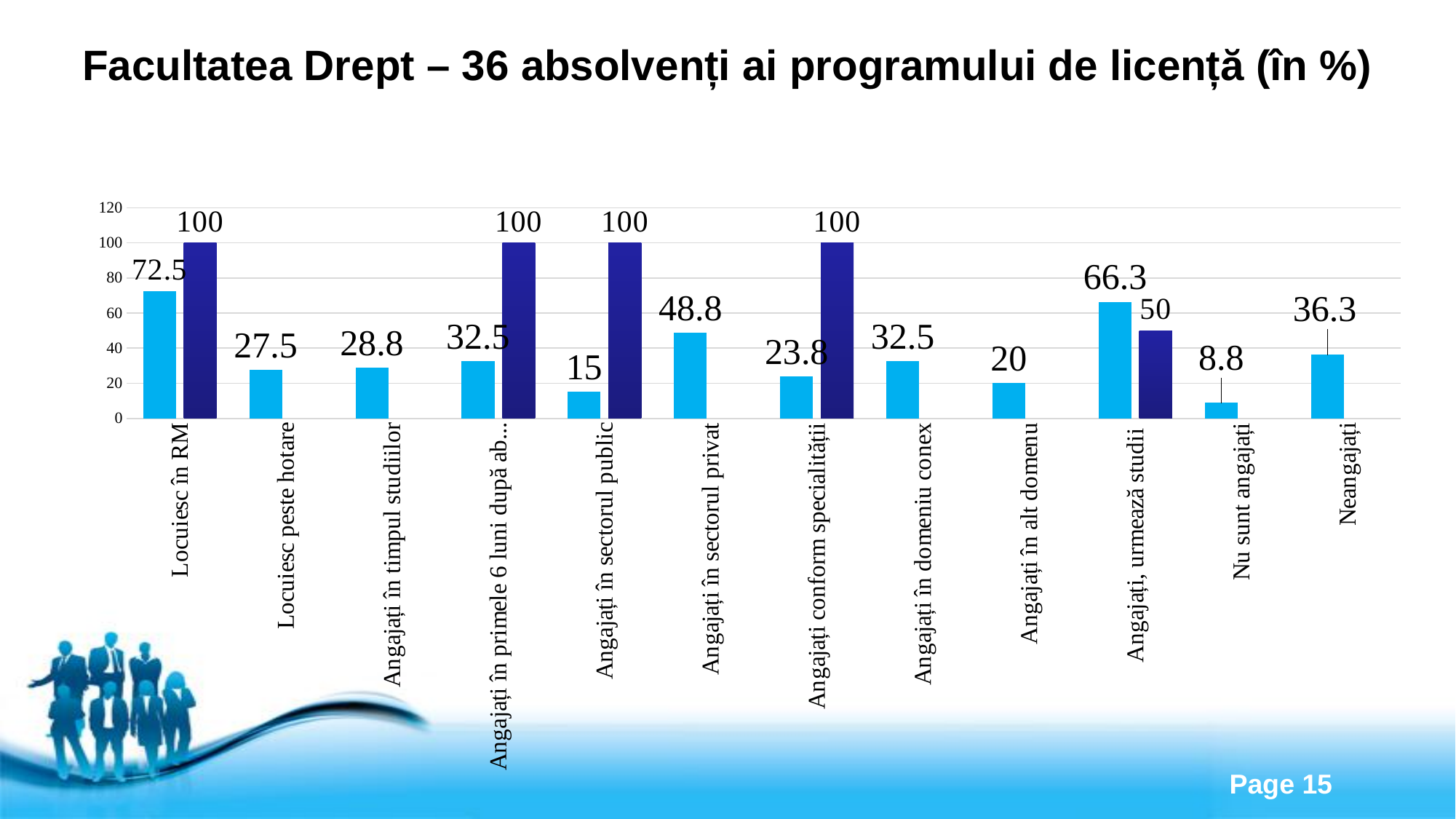
What is the difference between the light blue values for "Locuiesc în RM" and "Locuiesc peste hotare"? 45 What is the difference between the light blue values for "Angajați, urmează studii" and "Neangajați"? 30 What is the title of the slide containing the chart? Facultatea Drept – 36 absolvenți ai programului de licență (în %) Which category has the highest light blue bar? Locuiesc în RM What type of chart is shown on the slide? bar chart How many categories are shown on the x axis of the chart? 12 What is the value of the light blue bar for "Angajați în sectorul privat"? 48.8 What is the value of the dark blue bar for "Angajați, urmează studii"? 50 Which category has the lowest light blue bar? Nu sunt angajați What is the value of the light blue bar for "Locuiesc în RM"? 72.5 What is the value of the light blue bar for "Nu sunt angajați"? 8.8 Which light blue bar is larger: "Angajați în sectorul public" or "Angajați în sectorul privat"? Angajați în sectorul privat